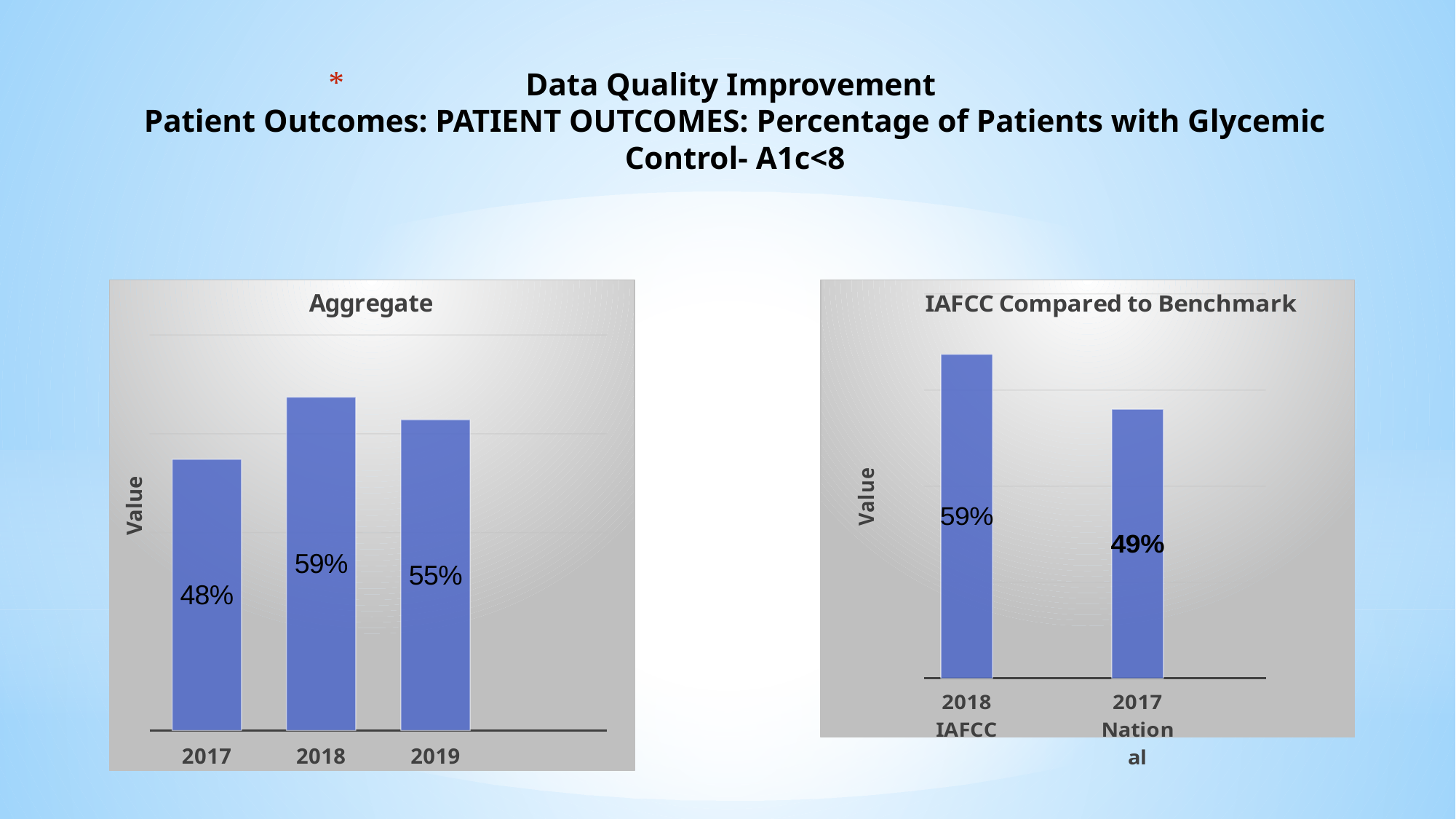
In the IAFCC Compared to Benchmark chart, what is the value for 2017 National? 49% In the Aggregate chart, what is the value for 2017? 48% In the IAFCC Compared to Benchmark chart, which is larger, 2018 IAFCC or 2017 National? 2018 IAFCC In the IAFCC Compared to Benchmark chart, what is the value for 2018 IAFCC? 59% In the Aggregate chart, what is the difference between the 2018 and 2017 values? 11% What type of chart is the Aggregate chart? Bar chart In the Aggregate chart, which year has the lowest value? 2017 In the Aggregate chart, how many years are shown? 3 In the Aggregate chart, what is the value for 2018? 59% In the Aggregate chart, what is the value for 2019? 55% In the IAFCC Compared to Benchmark chart, what is the difference between the 2018 IAFCC and 2017 National values? 10% In the Aggregate chart, which year has the highest value? 2018